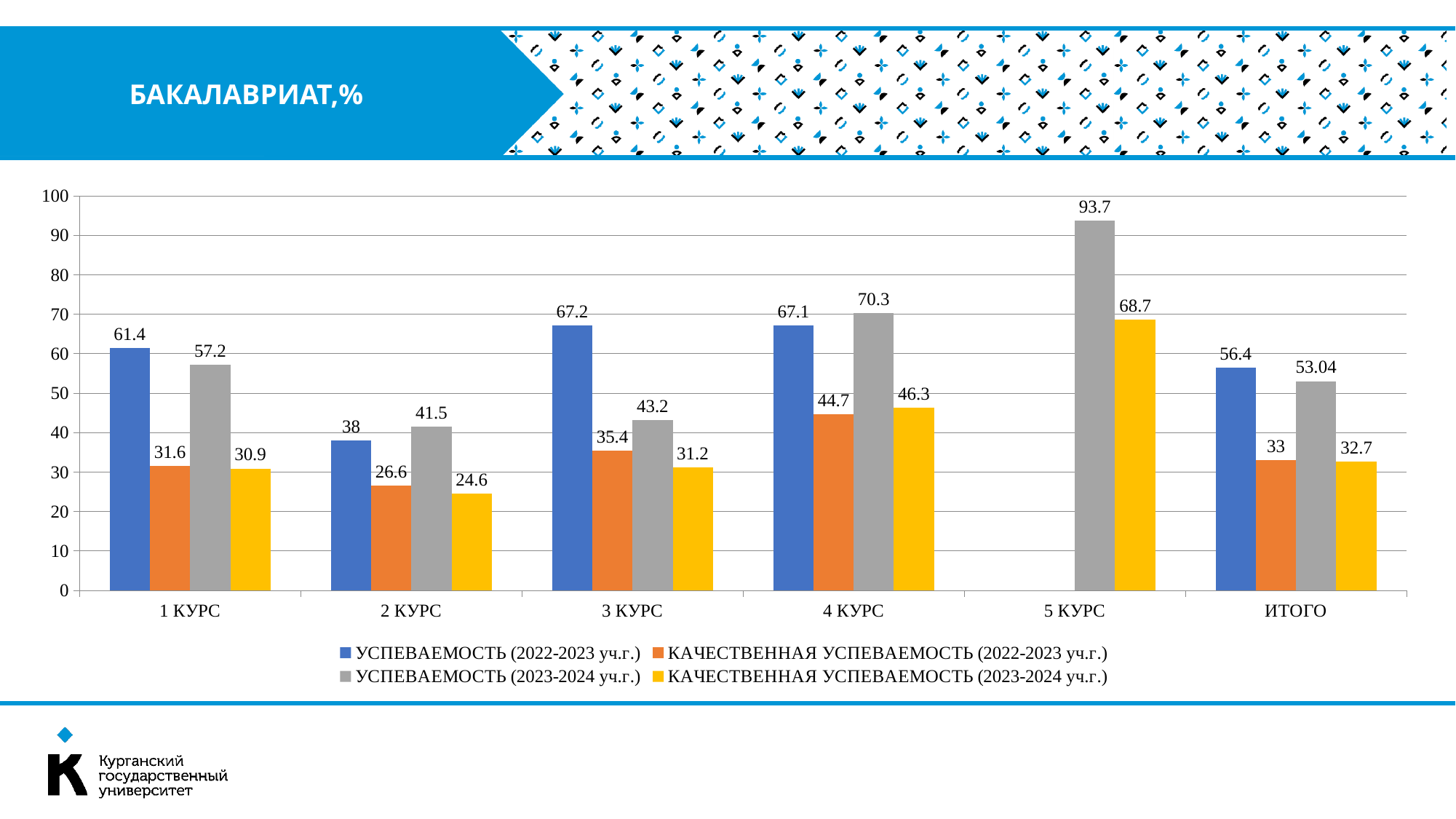
Which category has the highest value for УСПЕВАЕМОСТЬ (2023-2024 уч.г.)? 5 КУРС What is the title of the slide? БАКАЛАВРИАТ,% Which is larger for 1 КУРС: УСПЕВАЕМОСТЬ (2022-2023 уч.г.) or УСПЕВАЕМОСТЬ (2023-2024 уч.г.)? УСПЕВАЕМОСТЬ (2022-2023 уч.г.) What is the value of УСПЕВАЕМОСТЬ (2023-2024 уч.г.) for 5 КУРС? 93.7 What is the value of УСПЕВАЕМОСТЬ (2023-2024 уч.г.) for ИТОГО? 53.04 How many categories are shown on the x axis? 6 How many series does the legend list? 4 What is the value of КАЧЕСТВЕННАЯ УСПЕВАЕМОСТЬ (2022-2023 уч.г.) for 2 КУРС? 26.6 Which category has the lowest value for КАЧЕСТВЕННАЯ УСПЕВАЕМОСТЬ (2023-2024 уч.г.)? 2 КУРС What is the difference between УСПЕВАЕМОСТЬ (2023-2024 уч.г.) and УСПЕВАЕМОСТЬ (2022-2023 уч.г.) for 4 КУРС? 3.2 What kind of chart is shown on the slide? bar chart Is the value of КАЧЕСТВЕННАЯ УСПЕВАЕМОСТЬ (2023-2024 уч.г.) for 4 КУРС greater or less than 40? greater